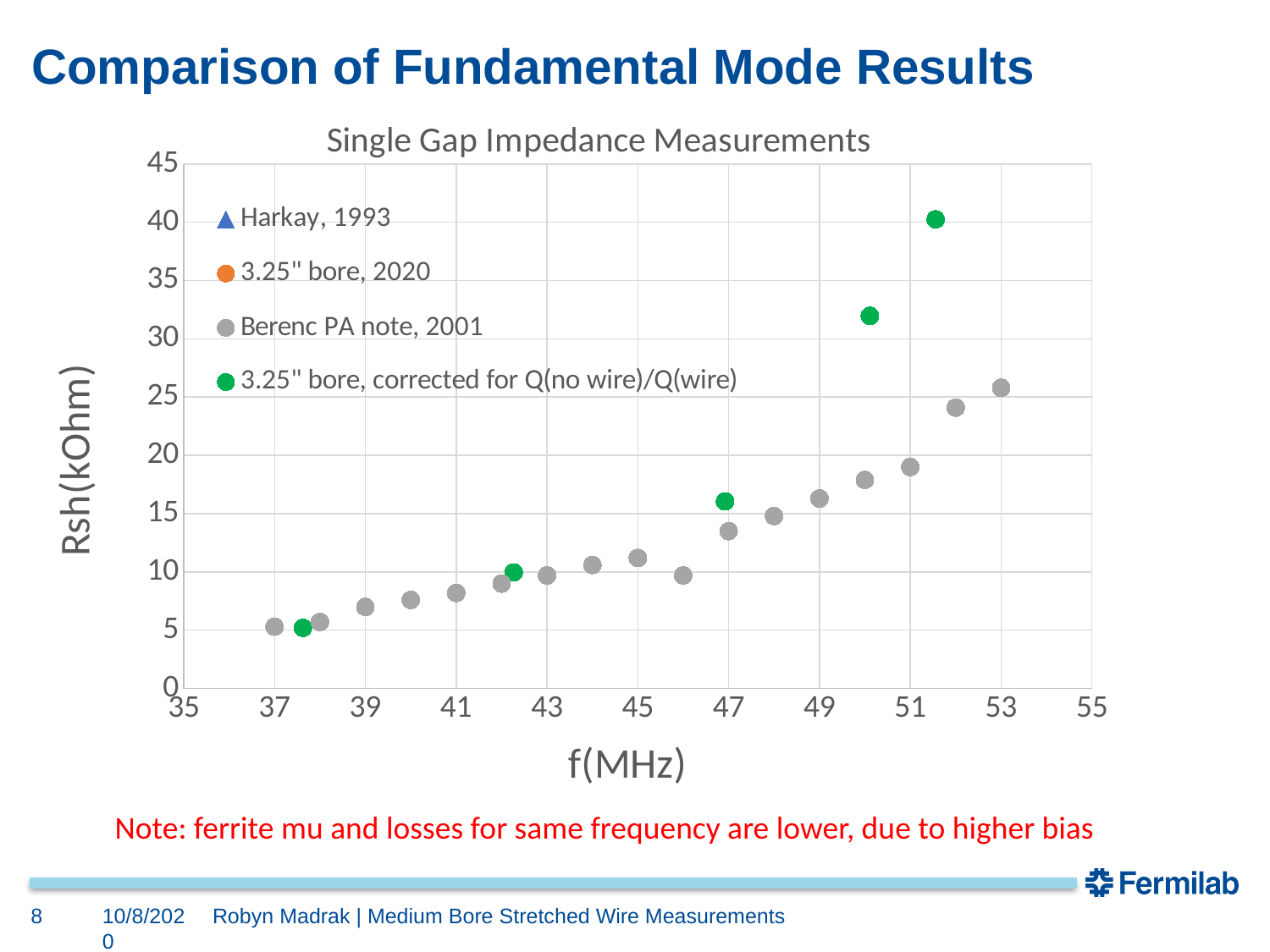
Is the Berenc PA note, 2001 point at 37 MHz greater or less than 10 kOhm? less Which series has the highest plotted point on the chart? 3.25" bore, corrected for Q(no wire)/Q(wire) Do the Berenc PA note, 2001 values generally rise or fall as frequency increases? rise Is the green point near 50 MHz greater or less than 30 kOhm? greater What is the label of the y axis? Rsh(kOhm) What kind of chart is shown on the slide? Scatter chart Is the highest green point, near 51.5 MHz, greater or less than 35 kOhm? greater How many green points (3.25" bore, corrected for Q(no wire)/Q(wire)) are plotted? 5 How many series does the chart legend list? 4 At around 50 MHz, which is larger: the green corrected 3.25" bore point or the gray Berenc PA note, 2001 point? The green corrected 3.25" bore point What is the title of the chart? Single Gap Impedance Measurements